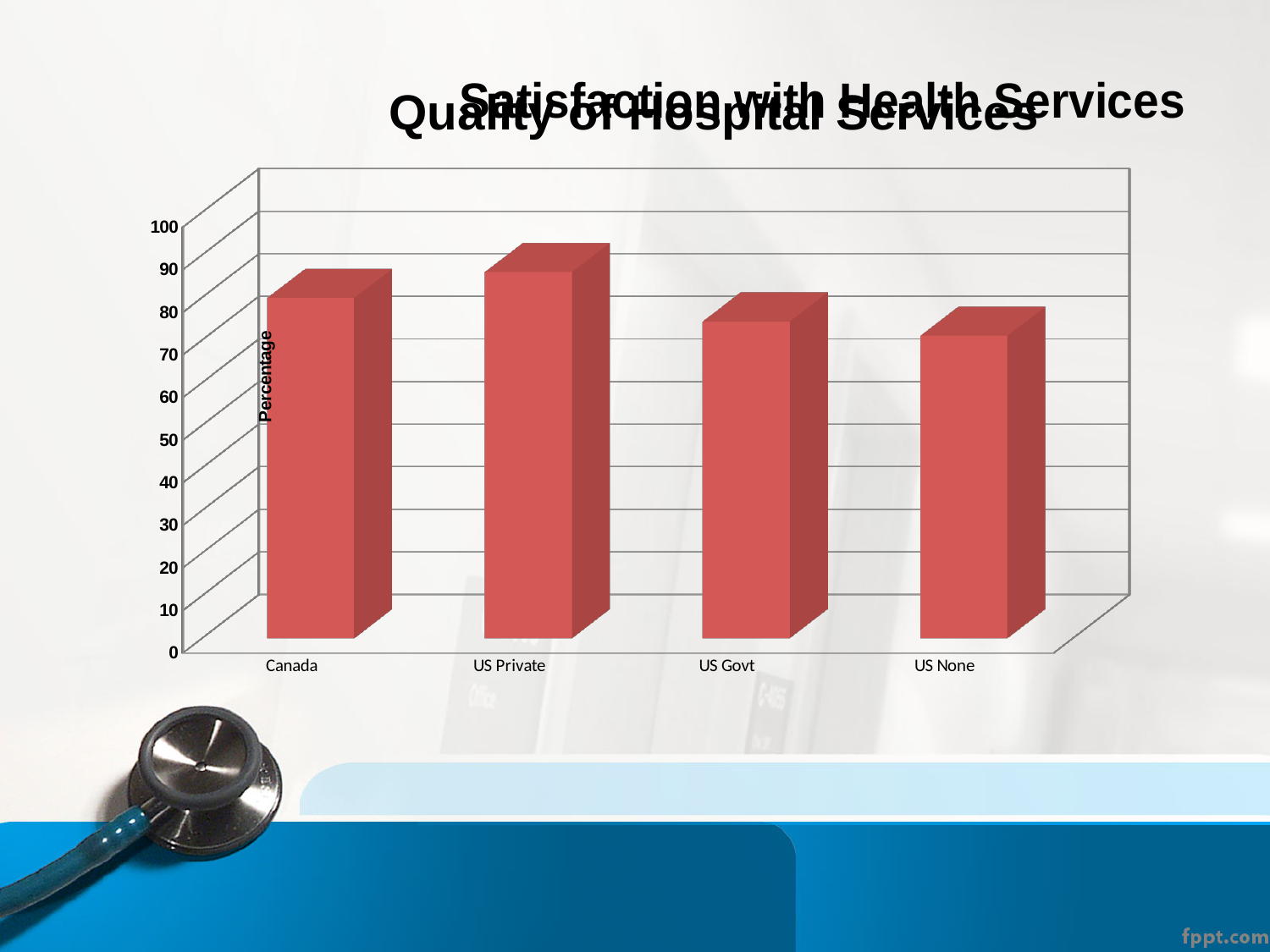
Which is larger, the value for Canada or the value for US Govt? Canada Which category has the highest bar in the chart? US Private Do the bar values rise or fall from US Private to US None along the x axis? fall Is the value for US Govt greater or less than 50? greater What is the label on the vertical axis of the chart? Percentage Is the value for US Private greater or less than 70? greater Is the value for US None greater or less than 90? less Which category has the lowest bar in the chart? US None Which is larger, the value for US Private or the value for US None? US Private How many categories are shown on the x axis of the chart? 4 What kind of chart is shown on the slide? bar chart